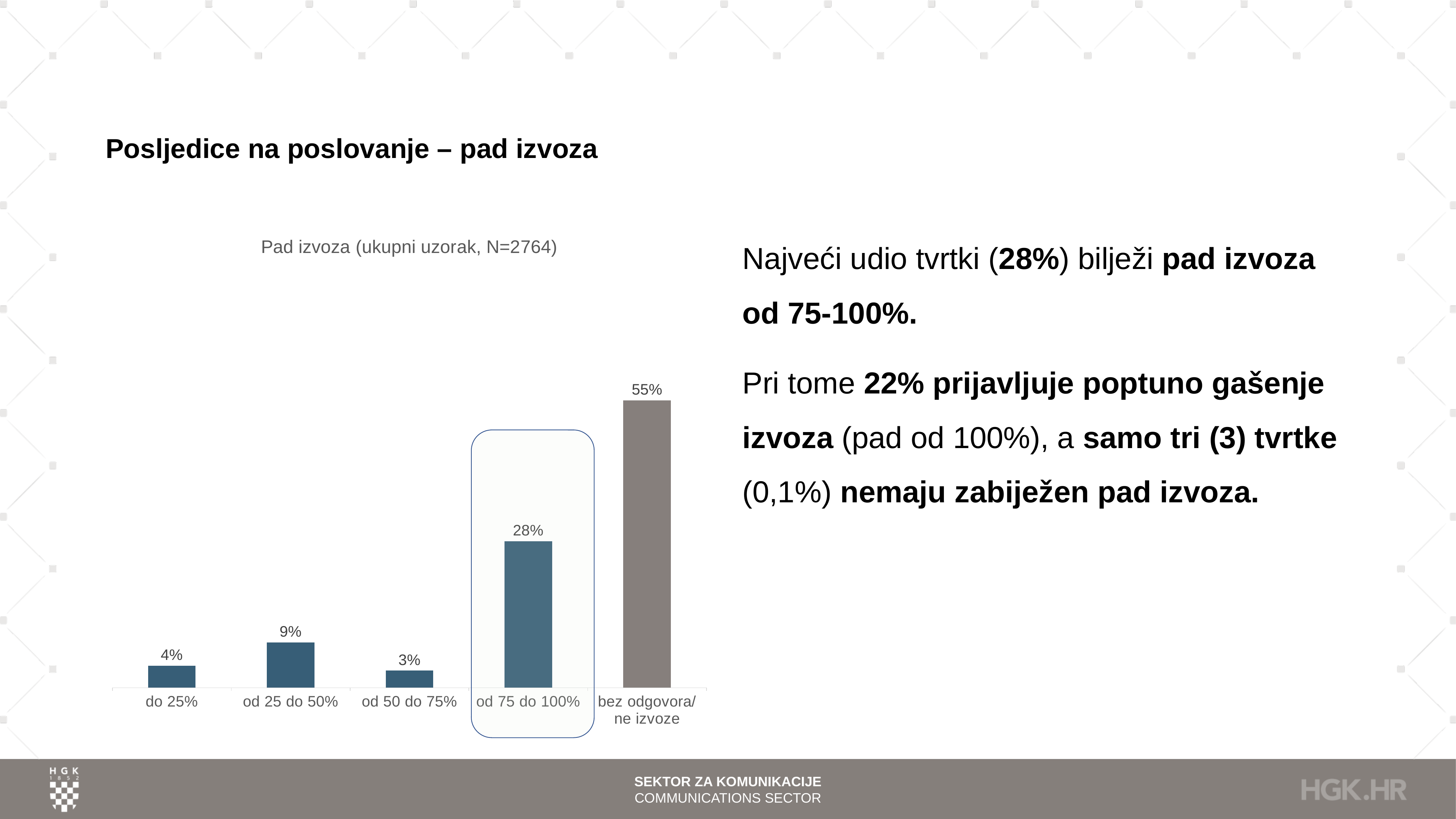
Which is larger, the value for 'od 25 do 50%' or the value for 'do 25%'? od 25 do 50% How many categories are shown on the x axis? 5 Which category's bar is highlighted with a rounded outline? od 75 do 100% Which category has the highest value? bez odgovora/ ne izvoze What is the title of the chart? Pad izvoza (ukupni uzorak, N=2764) What is the difference between the values for 'bez odgovora/ ne izvoze' and 'od 75 do 100%'? 27% What is the value for the 'od 25 do 50%' category? 9% What is the value for the 'do 25%' category? 4% Which category has the lowest value? od 50 do 75% What kind of chart is shown on the slide? bar chart What is the value for the 'bez odgovora/ ne izvoze' category? 55% What is the value for the 'od 75 do 100%' category? 28%